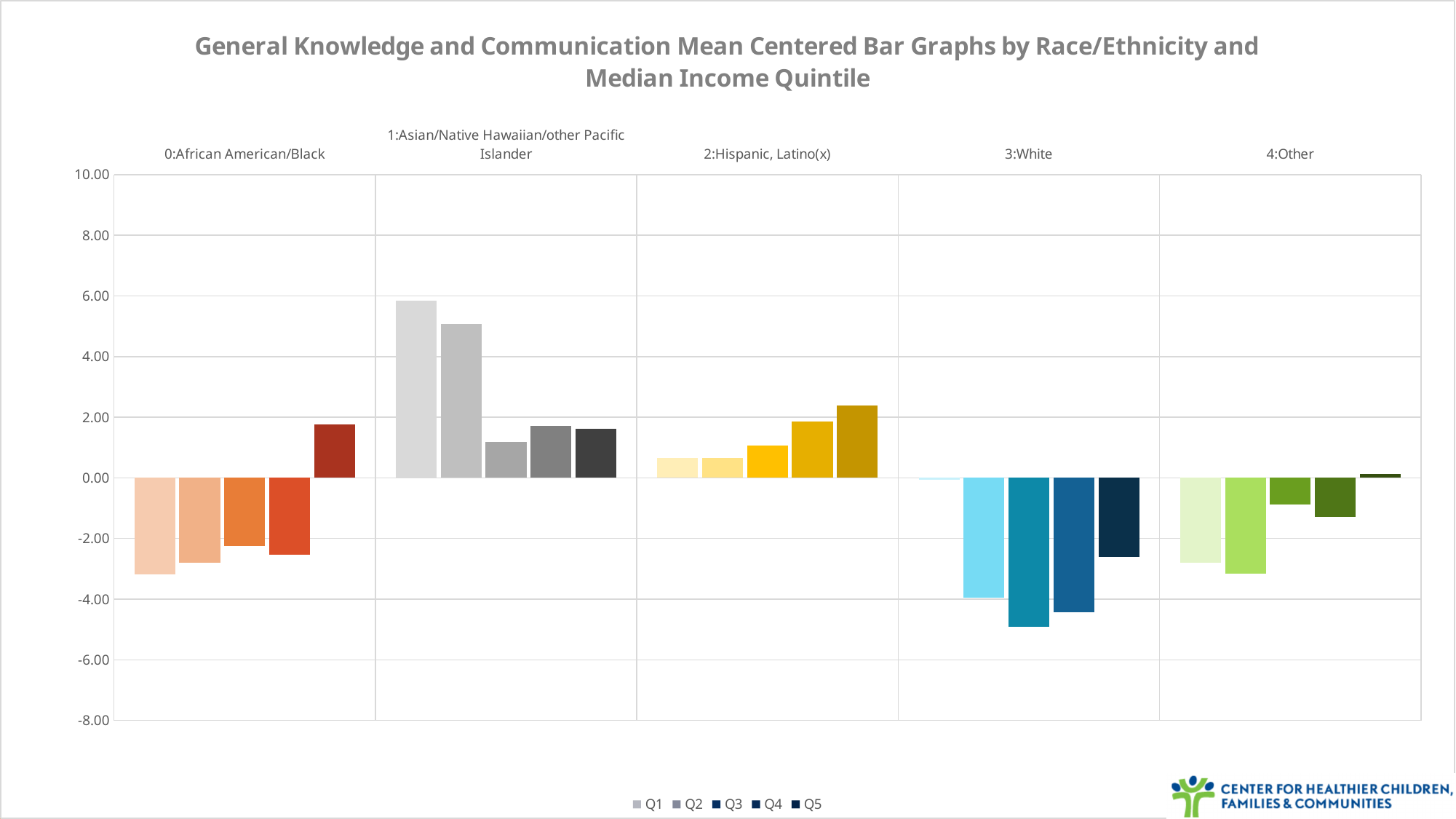
Which race/ethnicity group has all five quintile bars below zero? 3:White How many race/ethnicity groups are shown along the x axis? 5 What are the legend entries of the chart? Q1, Q2, Q3, Q4, Q5 For the 2:Hispanic, Latino(x) group, do the values rise or fall from Q1 to Q5? Rise Within the 3:White group, which quintile has the lowest bar? Q3 How many series does the legend list? 5 Is the Q5 value for 0:African American/Black greater or less than 0.00? greater Is the Q2 value for 3:White greater or less than -2.00? less Is the Q1 value for 1:Asian/Native Hawaiian/other Pacific Islander greater or less than 4.00? greater Which race/ethnicity group has the highest Q1 bar? 1:Asian/Native Hawaiian/other Pacific Islander What kind of chart is shown on the slide? Bar chart For the 2:Hispanic, Latino(x) group, which is larger, the Q1 value or the Q5 value? Q5